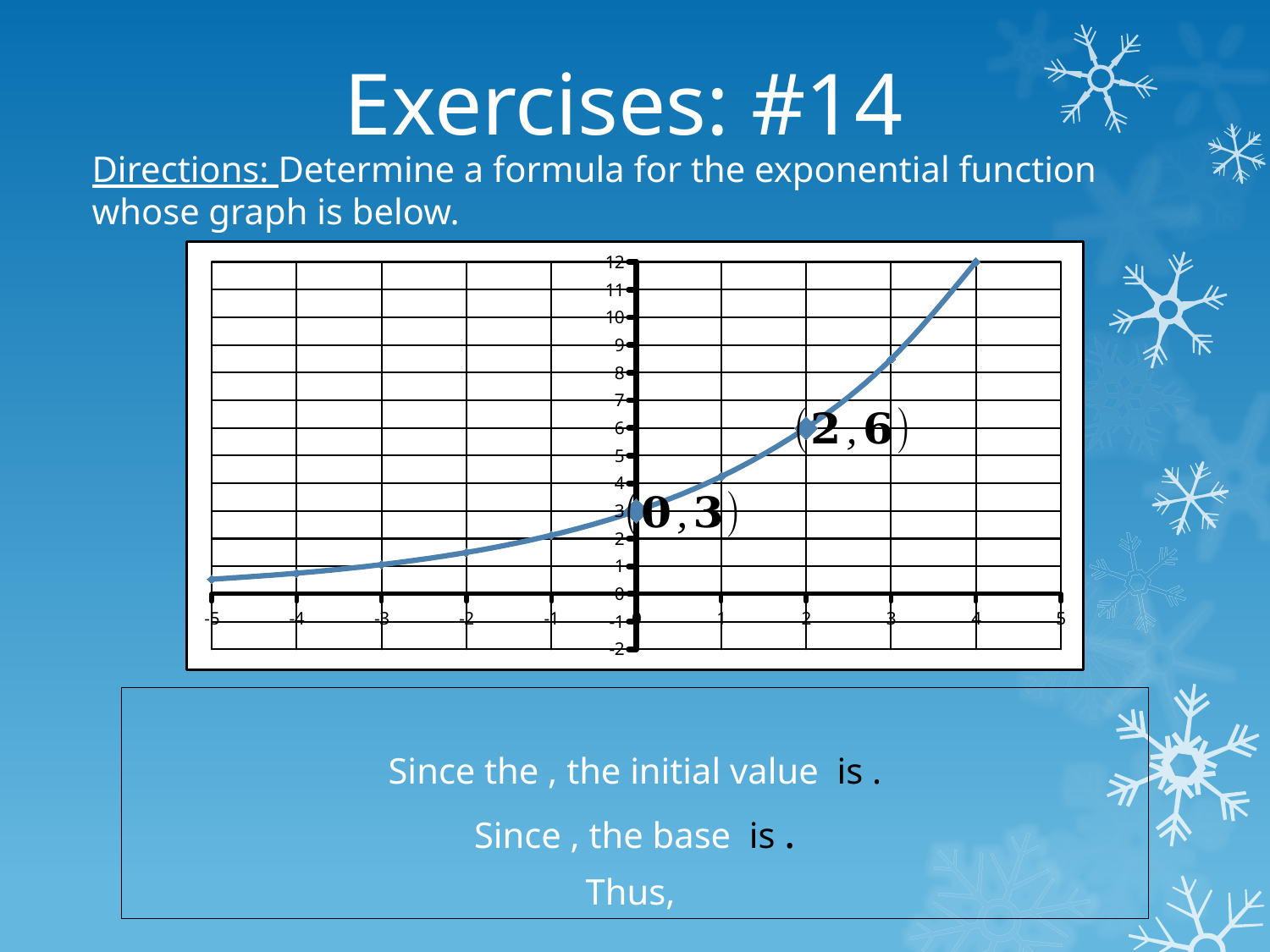
Is the value of the curve at x = 4 greater or less than 10? greater What kind of chart is shown on the slide? line chart Which labeled point has the larger y-value, the one at x = 0 or the one at x = 2? the one at x = 2 What is the y-value of the labeled point on the curve at x = 2? 6 How many points on the curve are labeled with coordinates? 2 Is the value of the curve at x = -2 greater or less than 2? less What range of x-values does the x-axis cover? -5 to 5 Do the values of the curve rise or fall as x increases from left to right? rise What is the y-value of the labeled point on the curve at x = 0? 3 What is the difference between the y-values of the labeled points at x = 2 and x = 0? 3 What is the highest value shown on the y-axis? 12 Is the value of the curve at x = 3 greater or less than 7? greater